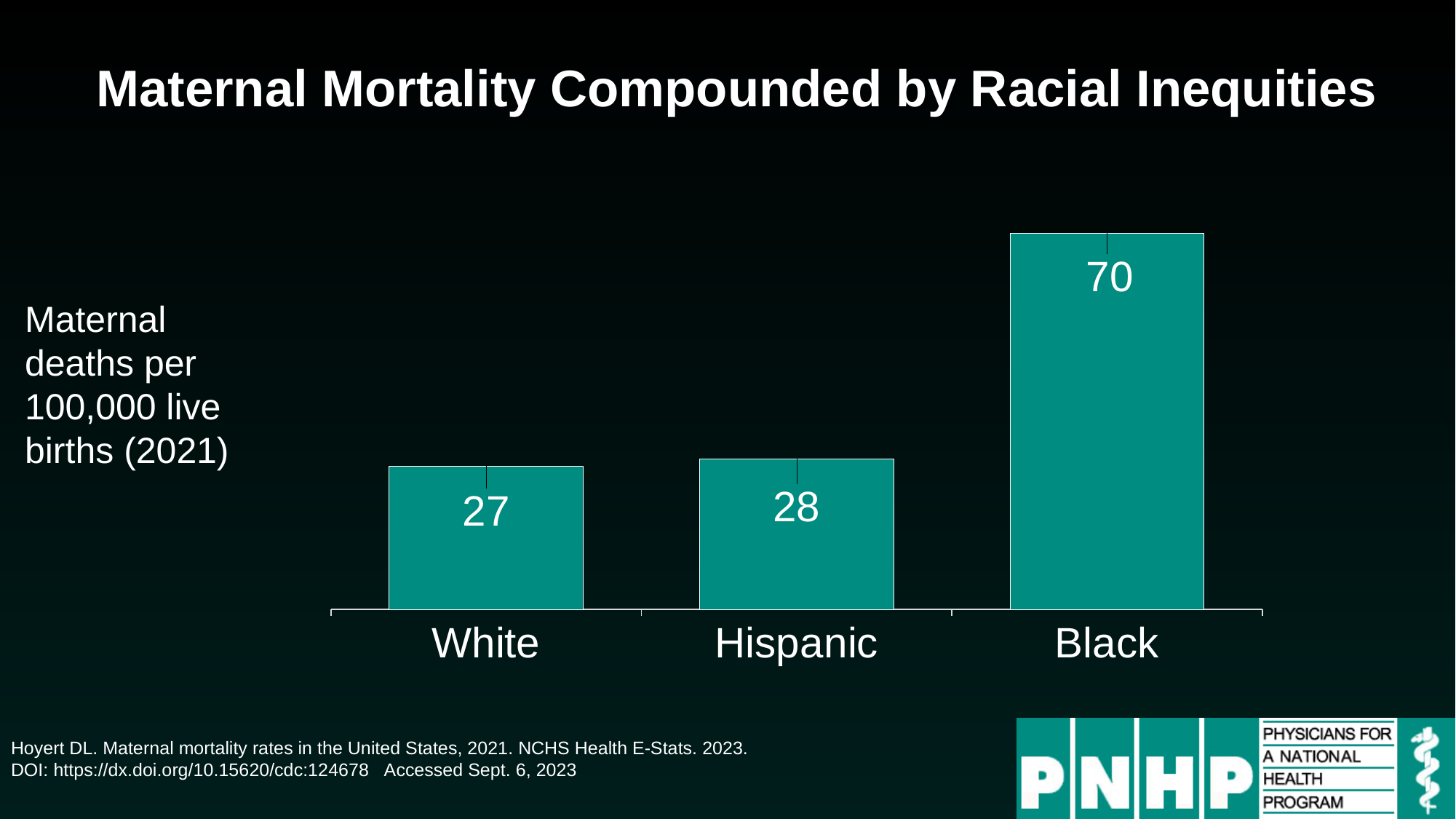
What is the maternal mortality rate for Black women shown on the chart? 70 What is the value for White on the chart? 27 What is the difference between the values for Hispanic and White? 1 Which category has the highest maternal mortality rate? Black Which category has the lowest maternal mortality rate? White Which is larger, the value for Black or the value for Hispanic? Black What is the difference between the values for Black and White? 43 How many categories are shown on the chart? 3 What is the title of the slide? Maternal Mortality Compounded by Racial Inequities What kind of chart is shown on the slide? Bar chart What is the value for Hispanic on the chart? 28 Do the values rise or fall moving from left to right across the categories? Rise